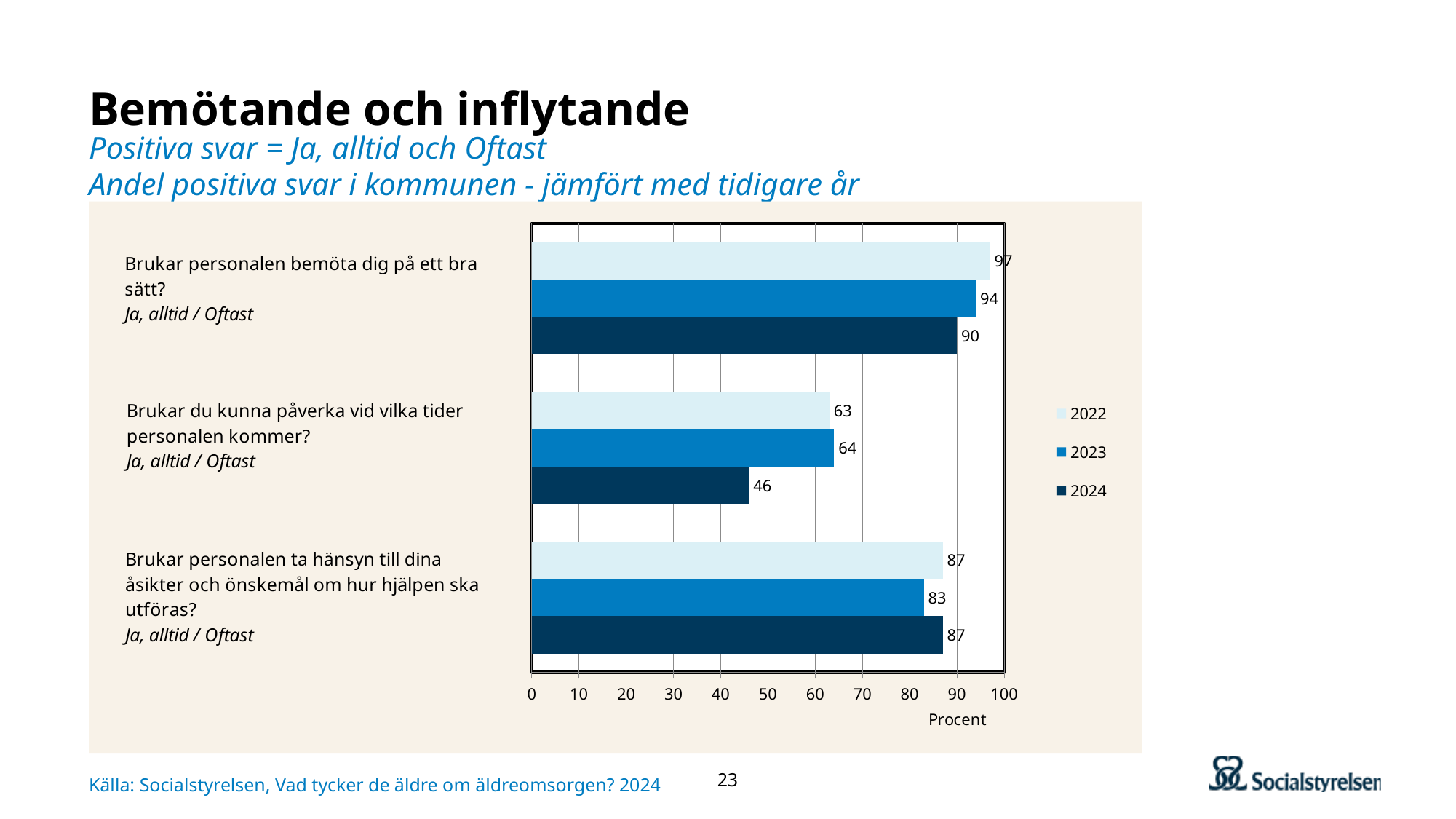
What is the difference between the 2023 and 2024 values for "Brukar du kunna påverka vid vilka tider personalen kommer?" 18 What kind of chart is shown on the slide? Bar chart How many series does the legend list? 3 Which question has the lowest 2024 value? Brukar du kunna påverka vid vilka tider personalen kommer? Which year has the highest value for "Brukar personalen bemöta dig på ett bra sätt?" 2022 What is the 2024 value for "Brukar personalen bemöta dig på ett bra sätt?" 90 Is the 2024 value for "Brukar du kunna påverka vid vilka tider personalen kommer?" greater or less than 50? less What is the 2022 value for "Brukar du kunna påverka vid vilka tider personalen kommer?" 63 What is the label on the horizontal axis of the chart? Procent How many questions (categories) are shown in the chart? 3 What is the 2023 value for "Brukar personalen ta hänsyn till dina åsikter och önskemål om hur hjälpen ska utföras?" 83 For "Brukar personalen ta hänsyn till dina åsikter och önskemål om hur hjälpen ska utföras?", is the 2022 value or the 2023 value larger? 2022